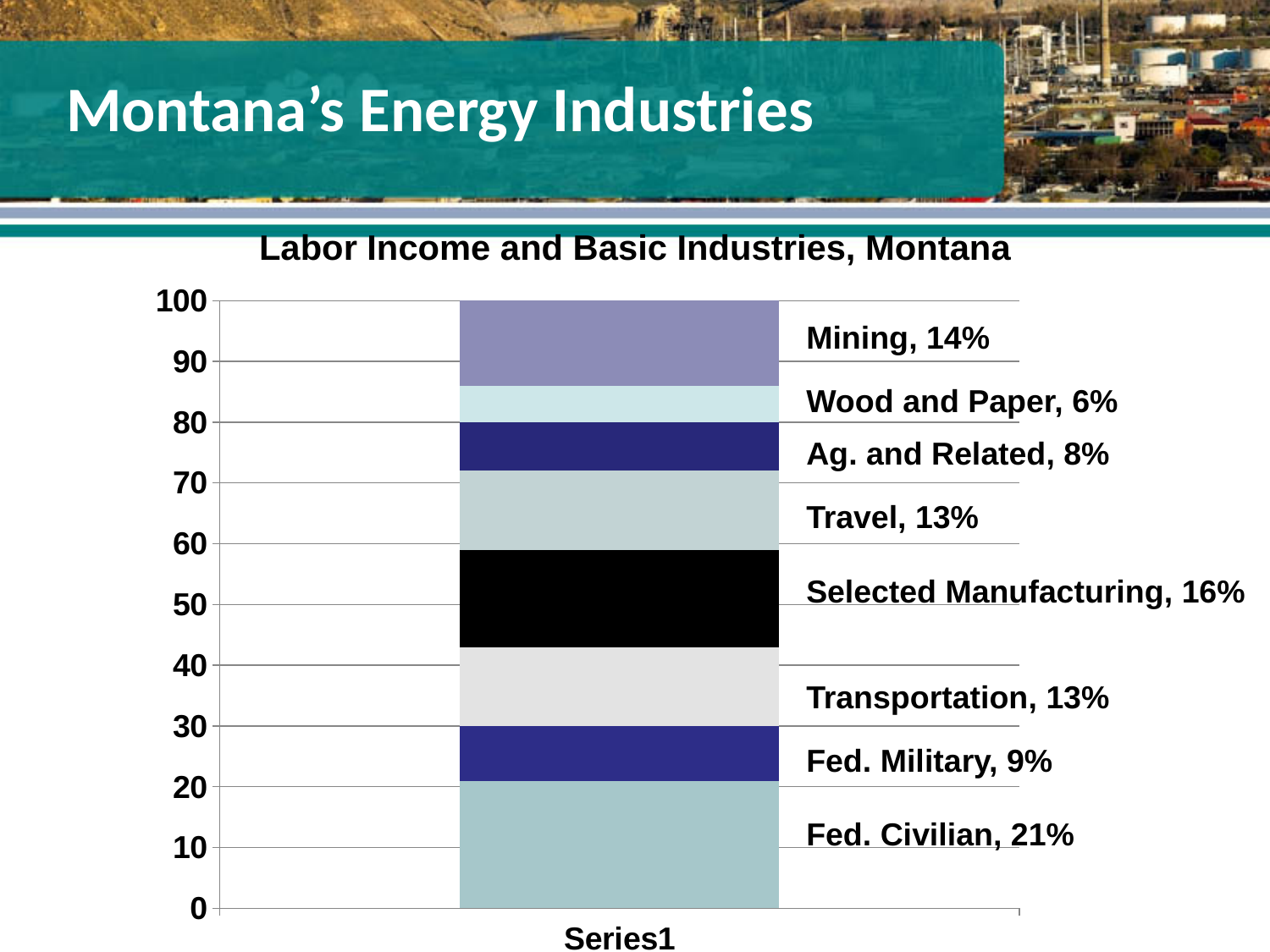
What is the total of all the segments in the stacked bar? 100% What is the title of the chart? Labor Income and Basic Industries, Montana What kind of chart is shown on the slide? Stacked bar chart What is the label shown on the x axis under the bar? Series1 Which is larger, the Travel share or the Fed. Military share? Travel Which segment has the smallest share of the bar? Wood and Paper What percentage is shown for Selected Manufacturing? 16% How many segments make up the stacked bar? 8 Which segment has the largest share of the bar? Fed. Civilian What is the difference between the Fed. Civilian and Mining percentages? 7% What percentage is shown for Wood and Paper? 6% What percentage is shown for Fed. Civilian? 21%